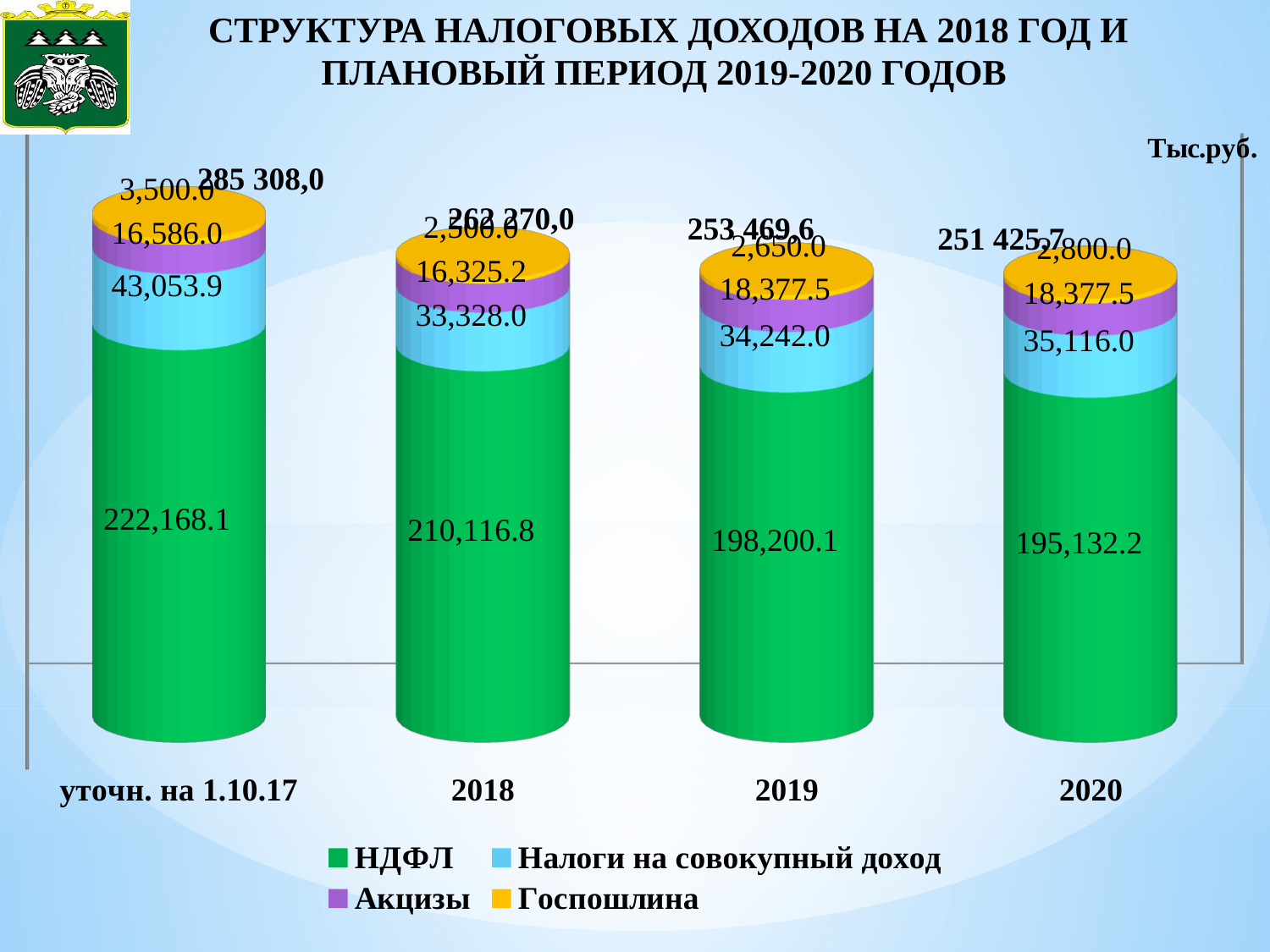
Which category has the lowest value for НДФЛ? 2020 How many series does the legend list? 4 What is the total of the stacked bar for 2020? 251 425,7 Which is larger, Налоги на совокупный доход for 2019 or for 2020? 2020 What is the value of Госпошлина for 2019? 2,650.0 Which category has the highest value for НДФЛ? уточн. на 1.10.17 What is the difference between the НДФЛ values for 2018 and 2019? 11,916.7 What is the value of Налоги на совокупный доход for уточн. на 1.10.17? 43,053.9 What is the value of Акцизы for 2020? 18,377.5 What kind of chart is shown on the slide? Stacked bar chart What is the value of НДФЛ for 2019? 198,200.1 How many categories are shown on the x axis? 4